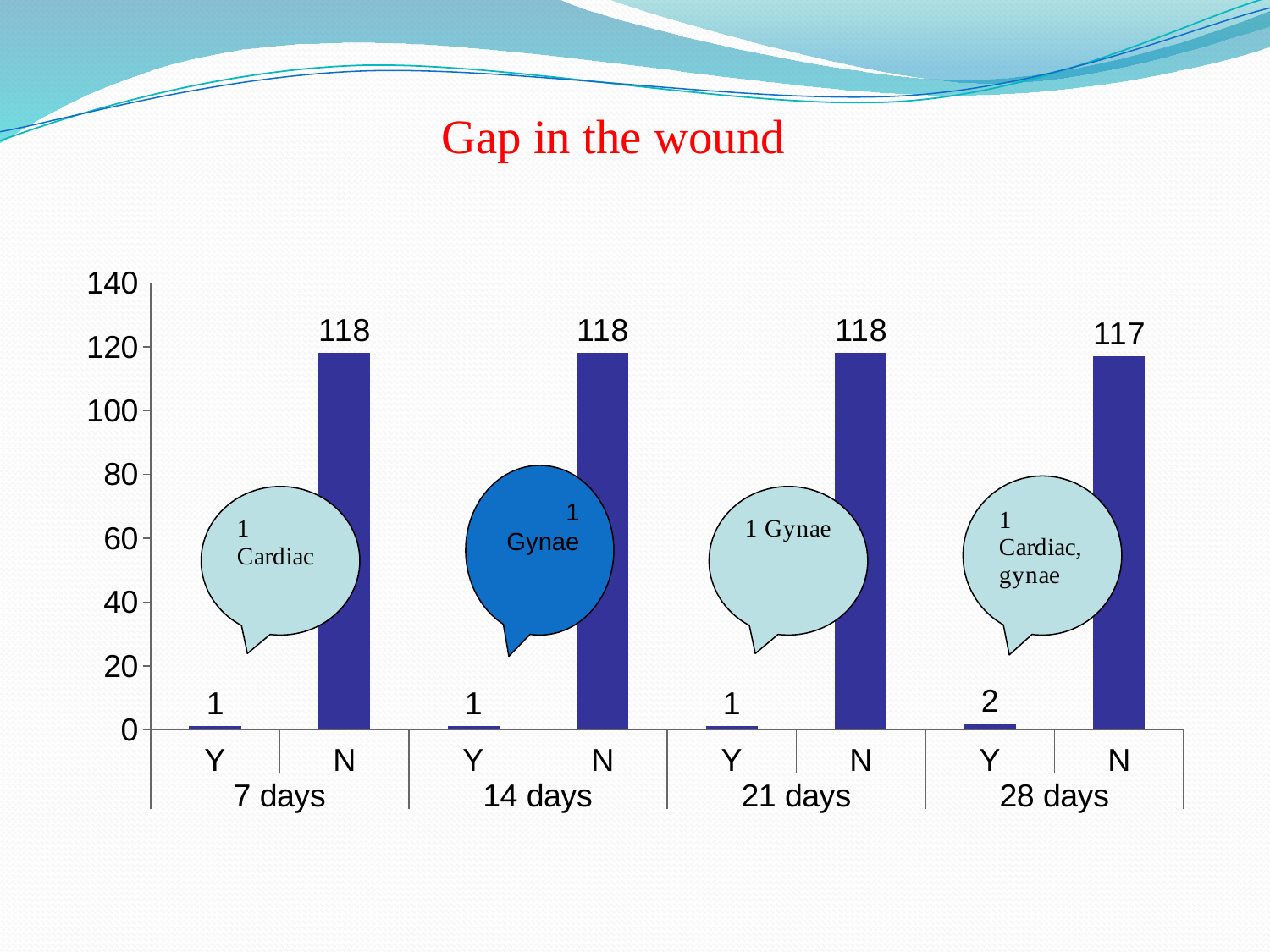
Which time point has the lowest N value? 28 days Which is larger at 21 days, the Y value or the N value? N What is the difference between the N and Y values at 28 days? 115 What is the title of the chart? Gap in the wound What is the value for N at 28 days? 117 Which time point has the highest Y value? 28 days How many time-point groups are shown on the x axis? 4 What is the value for Y at 28 days? 2 What is the difference between the N value at 7 days and the N value at 28 days? 1 What is the value for N at 7 days? 118 What is the value for Y at 14 days? 1 What kind of chart is shown on the slide? Bar chart